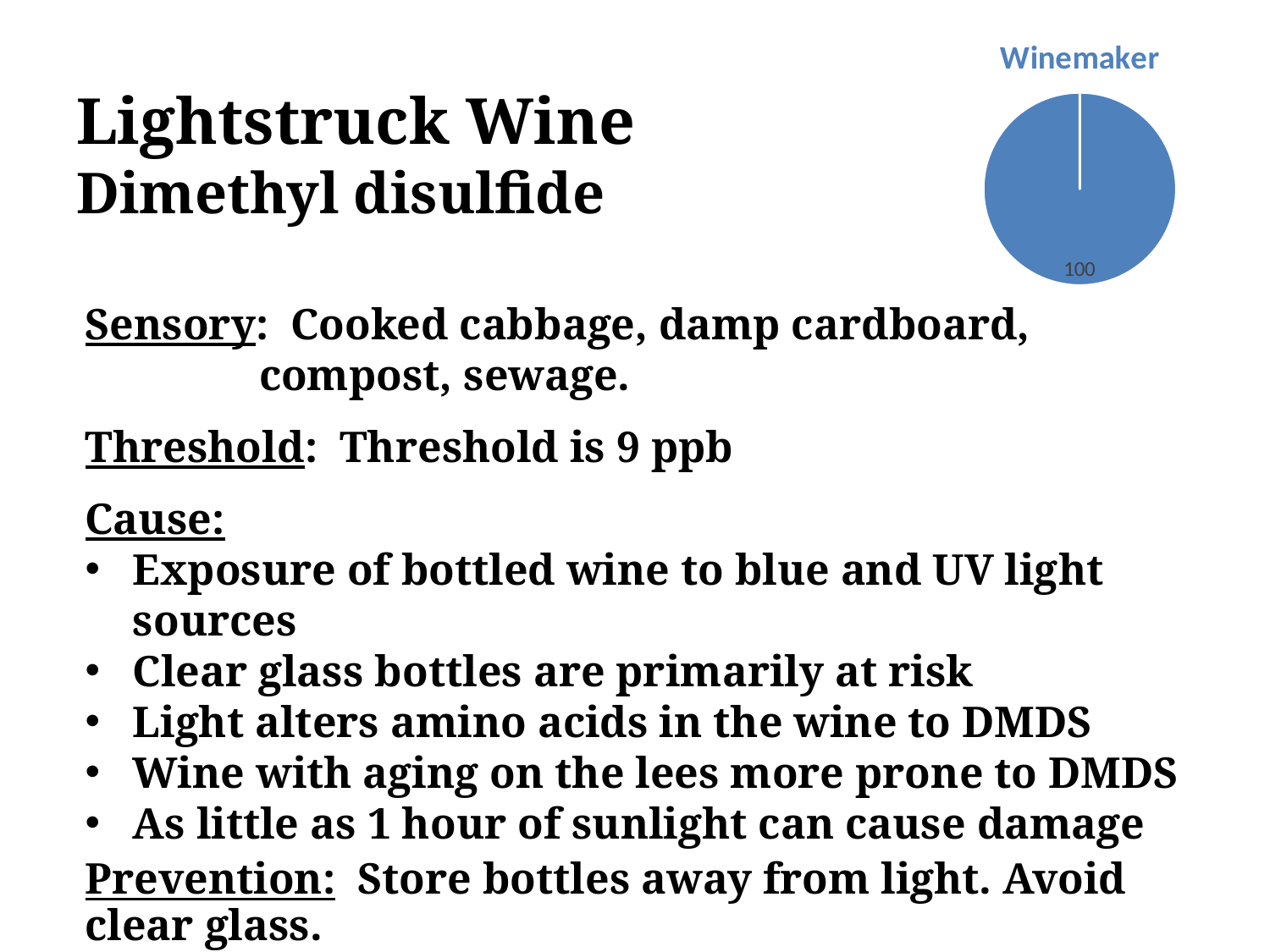
How many slices does the Winemaker pie chart have? 1 What share of the Winemaker pie does its single slice represent? 100% What kind of chart is shown on the slide? pie chart What value is printed on the slice of the Winemaker pie chart? 100 What is the title of the chart on the slide? Winemaker What colour is the slice in the Winemaker pie chart? blue